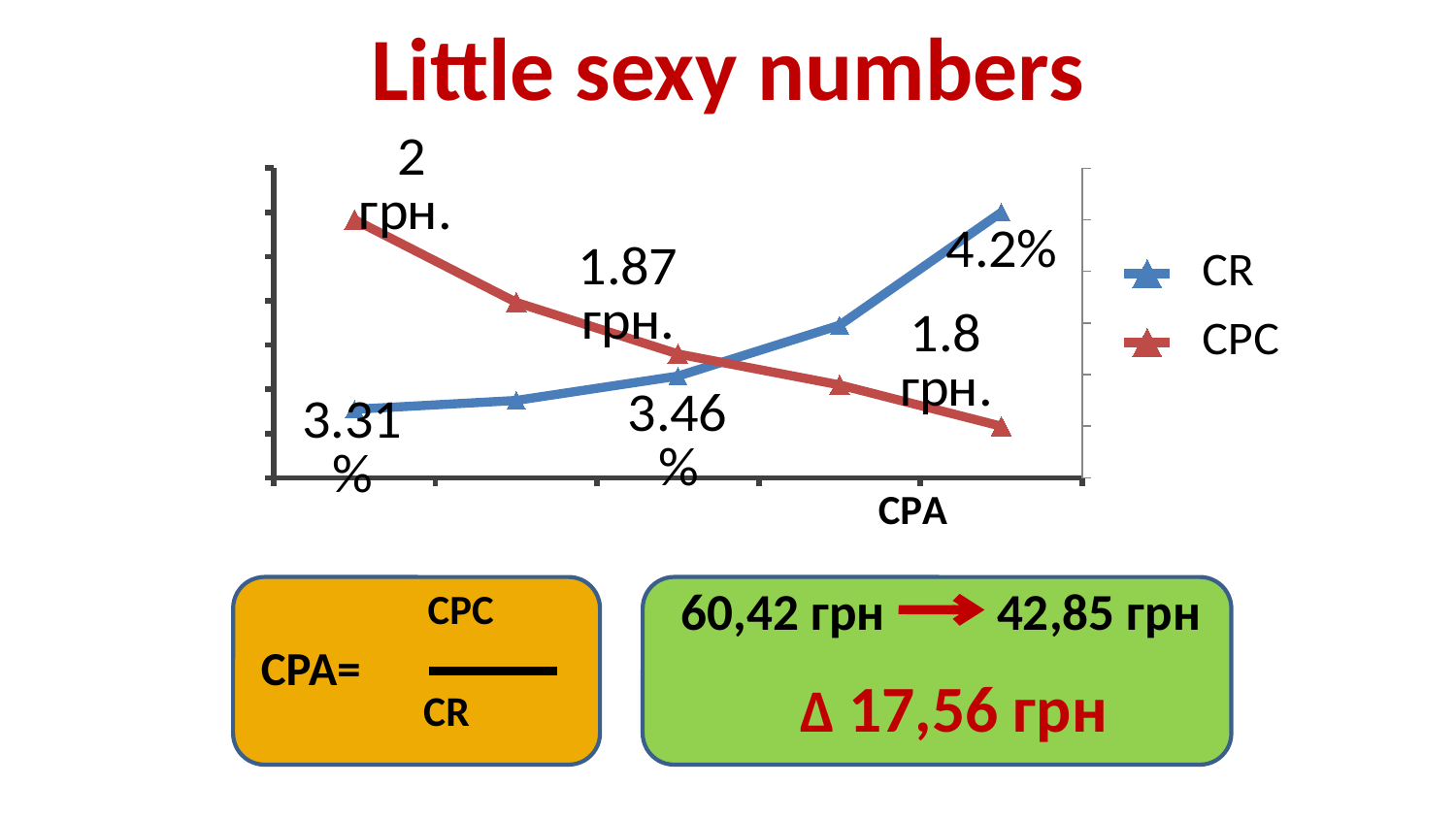
What is the CPC value labelled at the leftmost point of the chart? 2 грн. What is the CPC value labelled at the rightmost point of the chart? 1.8 грн. What kind of chart is shown on the slide? Line chart What is the CR value labelled at the leftmost point of the chart? 3.31% Does the CPC line rise or fall from left to right along the x axis? Falls What is the CR value labelled at the middle point of the chart? 3.46% What is the CR value labelled at the rightmost point of the chart? 4.2% How many series does the chart legend list? 2 How many data points does each line in the chart have? 5 Which two series are listed in the chart legend? CR and CPC Does the CR line rise or fall from left to right along the x axis? Rises What is the CPC value labelled at the middle point of the chart? 1.87 грн.